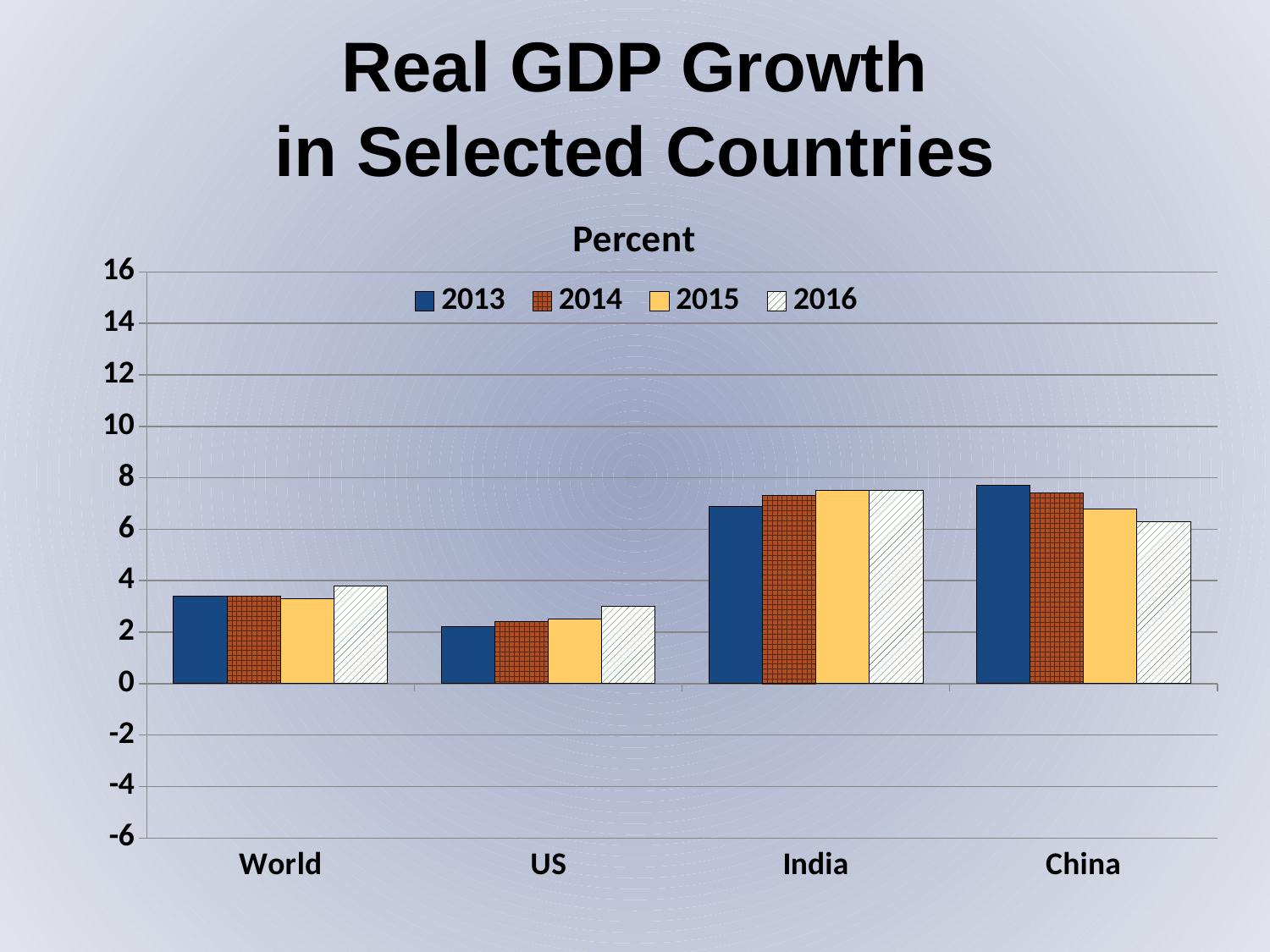
Which country or region has the lowest bar for 2013? US Is the value for US in 2013 greater or less than 4? less What is the label shown above the chart's y axis? Percent How many countries or regions are shown on the x axis? 4 Do the bars for China rise or fall from 2013 to 2016? fall What kind of chart is shown on the slide? bar chart Which years are listed in the legend? 2013, 2014, 2015, 2016 Which is larger, the 2016 value for India or the 2016 value for China? India Is the value for China in 2013 greater or less than 6? greater Which country or region has the highest bar for 2013? China How many series does the legend list? 4 Which country or region has the highest bar for 2016? India